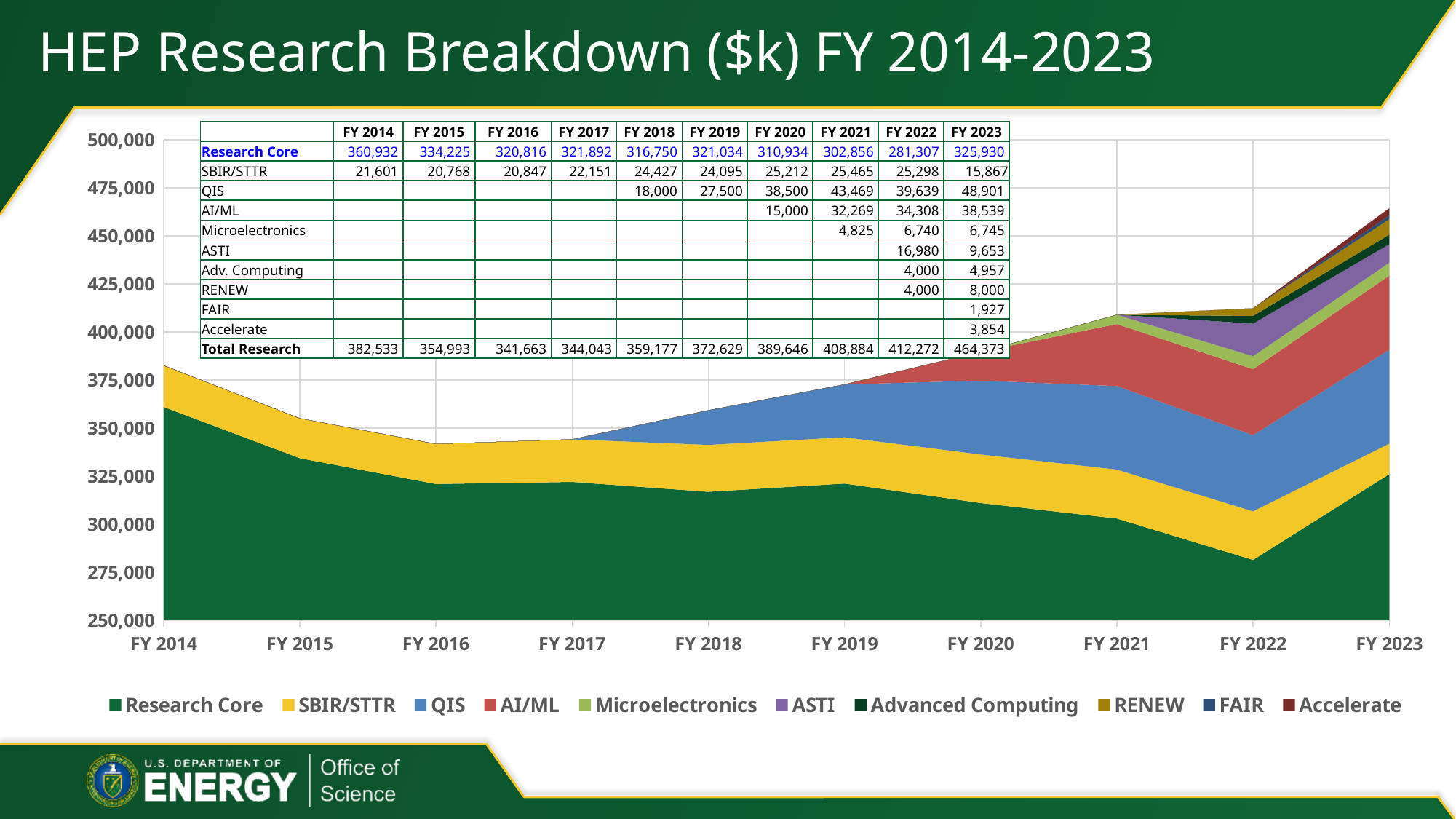
In which fiscal year is Total Research highest? FY 2023 Which is larger, the SBIR/STTR value for FY 2022 or for FY 2023? FY 2022 How many fiscal years are plotted along the x axis? 10 How many series does the chart legend list? 10 What is the Research Core value for FY 2014? 360,932 Does the Research Core value rise or fall from FY 2014 to FY 2022? Fall What is the title of the chart? HEP Research Breakdown ($k) FY 2014-2023 What is the AI/ML value for FY 2020? 15,000 What is the difference between Total Research in FY 2023 and FY 2022? 52,101 What is the QIS value for FY 2023? 48,901 What kind of chart is shown on the slide? Stacked area chart In which fiscal year is Total Research lowest? FY 2016